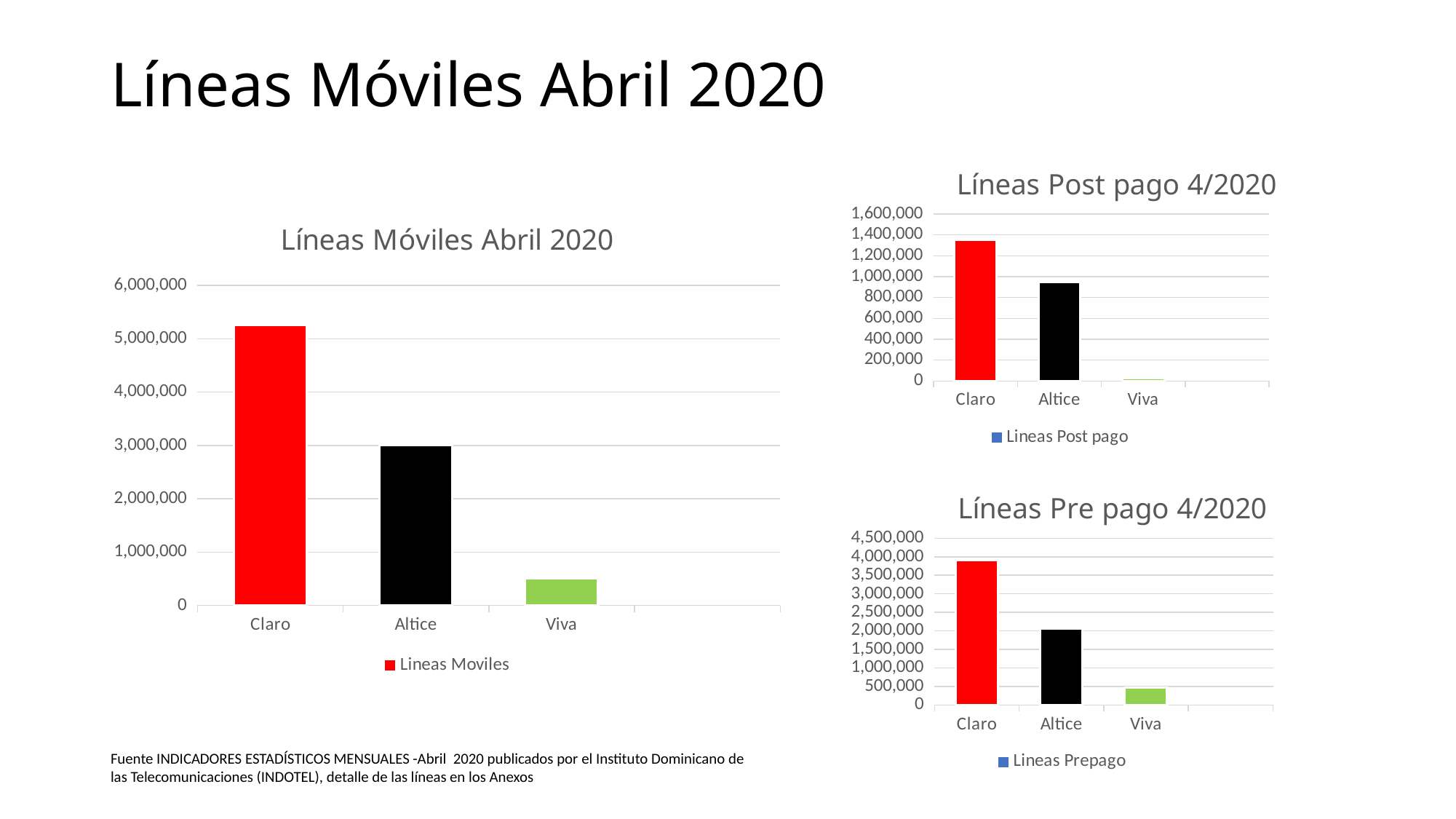
In the 'Líneas Post pago 4/2020' chart, which is larger, the value for Claro or the value for Altice? Claro What is the legend entry of the 'Líneas Post pago 4/2020' chart? Lineas Post pago In the 'Líneas Móviles Abril 2020' chart, is the value for Claro greater or less than 5,000,000? greater In the 'Líneas Móviles Abril 2020' chart, which category has the highest value? Claro In the 'Líneas Post pago 4/2020' chart, is the value for Altice greater or less than 1,000,000? less In the 'Líneas Post pago 4/2020' chart, which category has the highest value? Claro In the 'Líneas Móviles Abril 2020' chart, is the value for Viva greater or less than 1,000,000? less In the 'Líneas Pre pago 4/2020' chart, which category has the lowest value? Viva How many categories are shown in the 'Líneas Pre pago 4/2020' chart? 3 In the 'Líneas Móviles Abril 2020' chart, which category has the lowest value? Viva What kind of chart is the 'Líneas Móviles Abril 2020' chart? bar chart